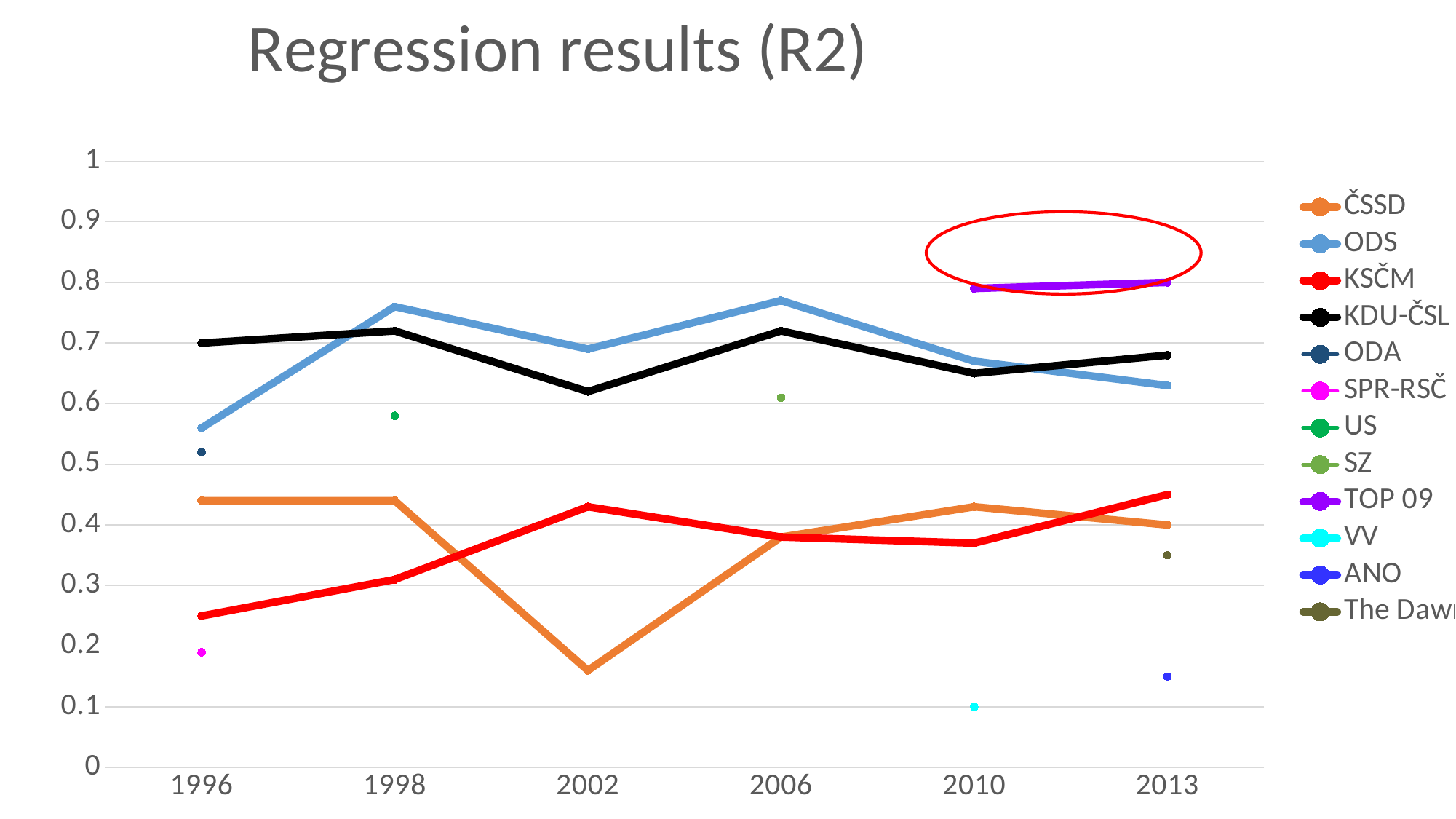
How many years are shown on the x axis? 6 Is the value for ODS in 1998 greater or less than 0.7? greater What is the title of the chart? Regression results (R2) What is the value for VV in 2010? 0.1 Is the value for ČSSD in 2002 greater or less than 0.2? less What kind of chart is shown on the slide? line chart Does the KSČM line rise or fall from 1996 to 2002? rise Which series has the highest value in 2013? TOP 09 Is the value for KSČM in 1996 greater or less than 0.3? less How many series does the legend list? 12 What is the value for KDU-ČSL in 1996? 0.7 Which is larger in 1996, the value for ODS or the value for KDU-ČSL? KDU-ČSL